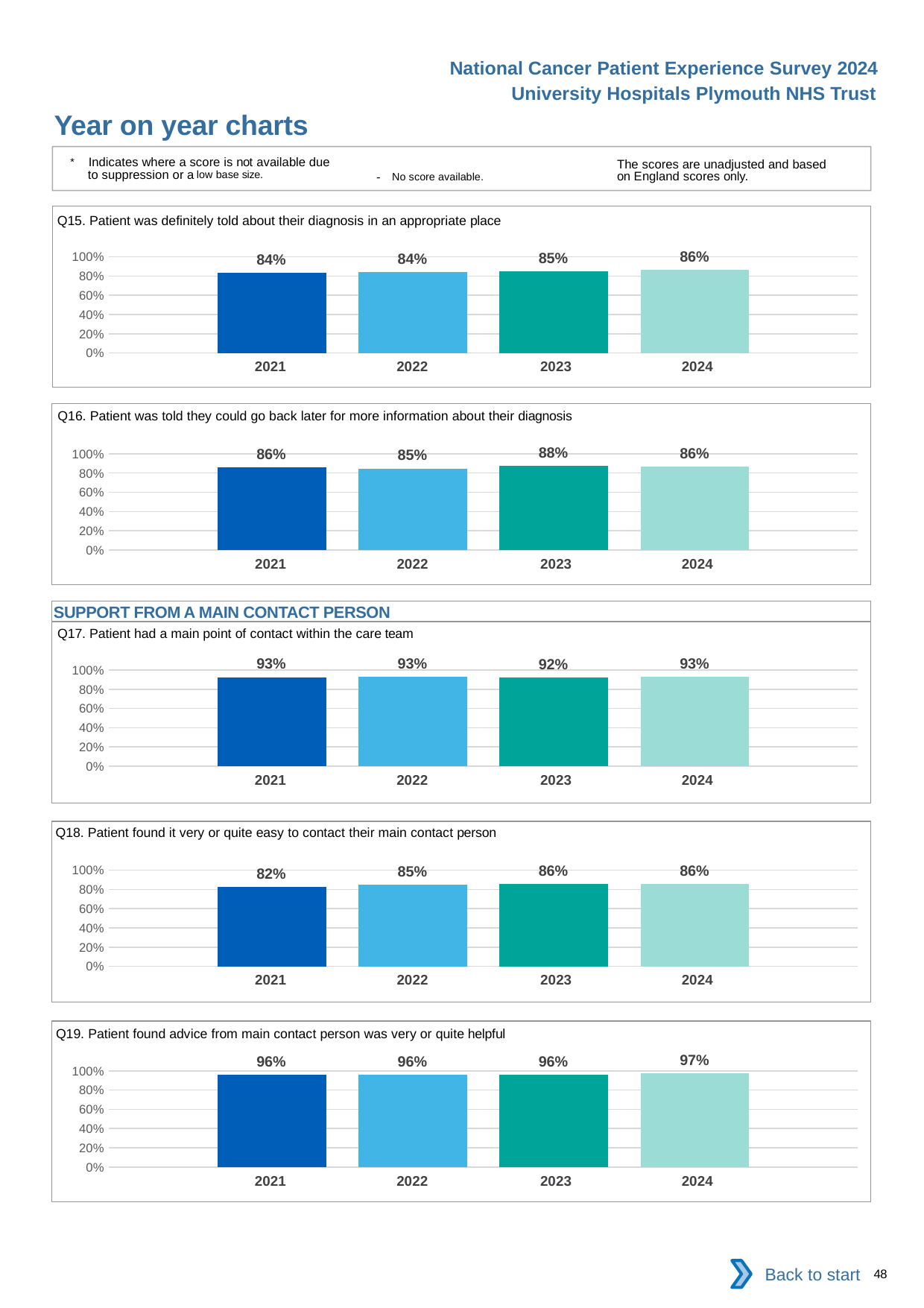
What kind of chart is the Q17 chart? bar chart In the Q15 chart, what is the value for 2024? 86% In the Q16 chart, what is the difference between the 2023 and 2022 values? 3% In the Q18 chart, what is the value for 2021? 82% In the Q16 chart, which year has the highest value? 2023 In the Q17 chart, which year has the lowest value? 2023 In the Q19 chart, what is the value for 2024? 97% How many years are shown in the Q15 chart? 4 In the Q19 chart, which year has the highest value? 2024 In the Q18 chart, what is the difference between the 2024 and 2021 values? 4% In the Q18 chart, is the value for 2022 or 2023 larger? 2023 In the Q15 chart, do the values rise or fall from 2021 to 2024? rise